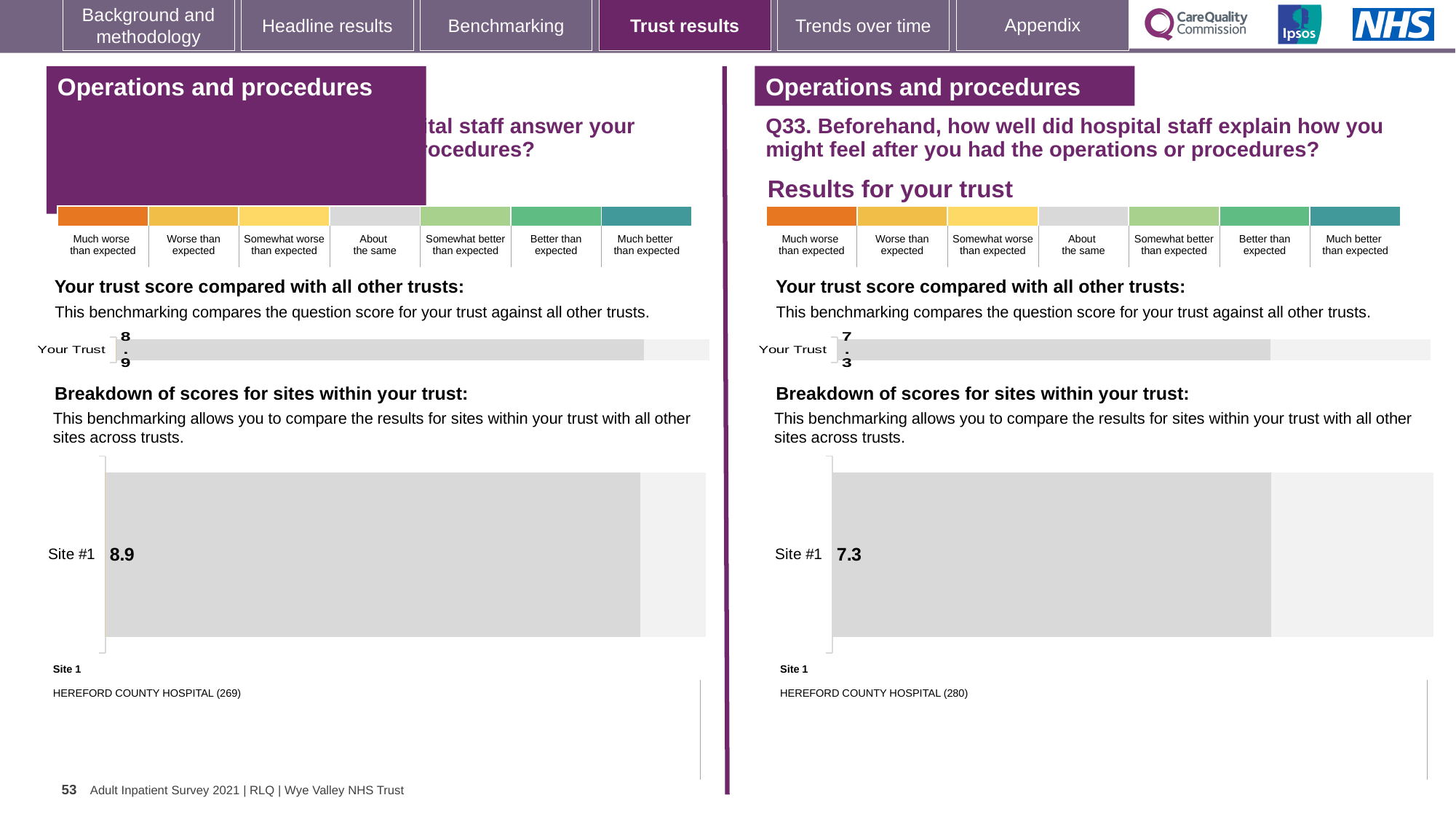
What is the difference between the Site #1 score on the left-hand panel and the Site #1 score on the right-hand panel (Q33)? 1.6 On the right-hand panel (Q33), what score is shown for Site #1 in the 'Breakdown of scores for sites within your trust' chart? 7.3 On the right-hand panel (Q33), is the Your Trust score the same as the Site #1 score? Yes On the left-hand panel, what is the score shown for Your Trust in the 'Your trust score compared with all other trusts' chart? 8.9 How many sites are shown in the 'Breakdown of scores for sites within your trust' chart on the right-hand panel (Q33)? 1 Which is larger: the Your Trust score on the left-hand panel or the Your Trust score on the right-hand panel (Q33)? Left-hand panel (8.9) On the right-hand panel (Q33), which hospital is listed as Site 1 below the breakdown chart? HEREFORD COUNTY HOSPITAL (280) On the left-hand panel, what score is shown for Site #1 in the 'Breakdown of scores for sites within your trust' chart? 8.9 On the right-hand panel (Q33), what is the score shown for Your Trust in the 'Your trust score compared with all other trusts' chart? 7.3 What type of chart is used to show the Site #1 score on the right-hand panel (Q33)? Bar chart On the left-hand panel, which hospital is listed as Site 1 below the breakdown chart? HEREFORD COUNTY HOSPITAL (269)